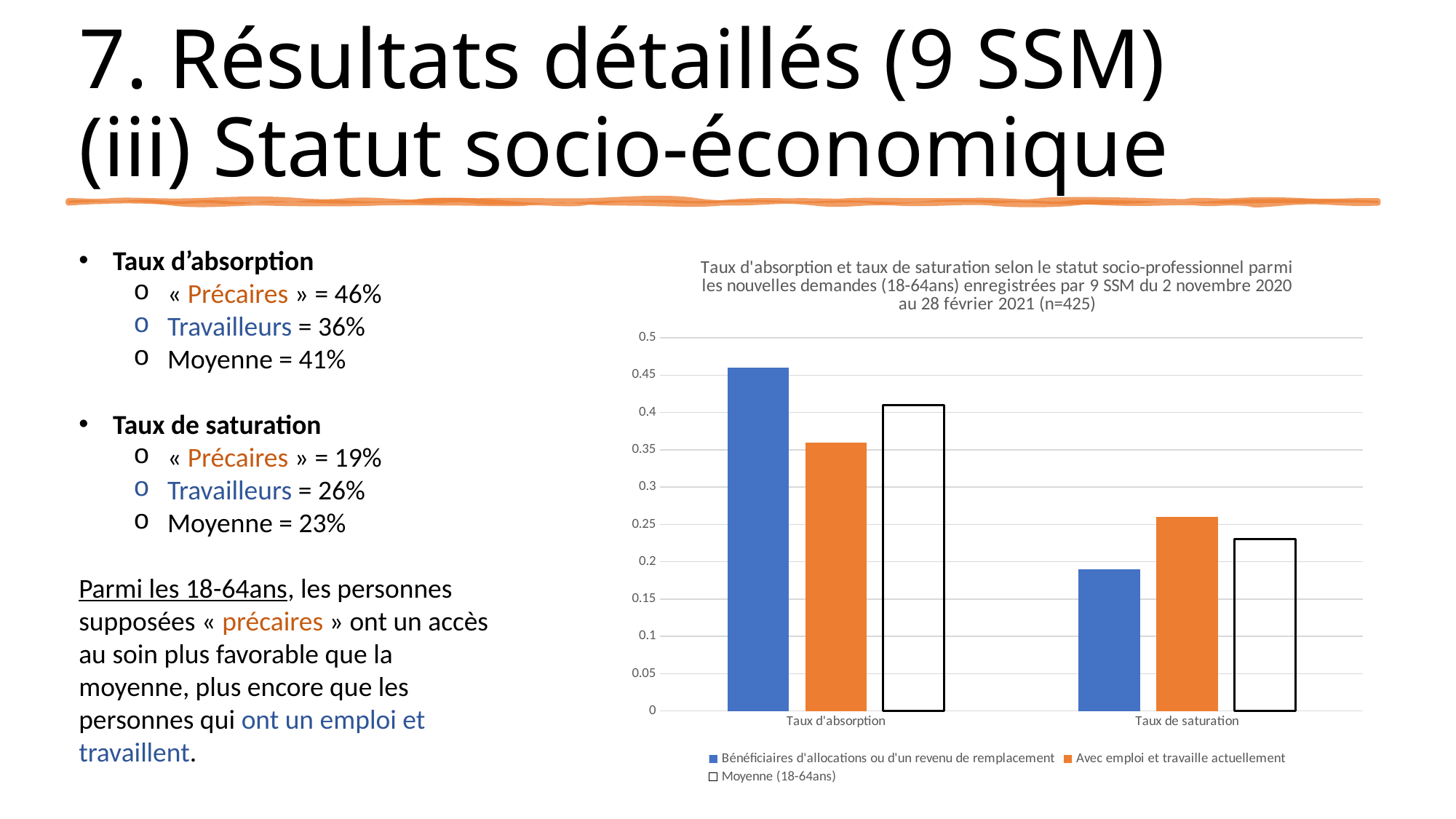
Do the values for each series rise or fall from Taux d'absorption to Taux de saturation? fall Is the value for Bénéficiaires d'allocations ou d'un revenu de remplacement in Taux d'absorption greater or less than 0.4? greater For Taux d'absorption, which is larger: Bénéficiaires d'allocations ou d'un revenu de remplacement or Avec emploi et travaille actuellement? Bénéficiaires d'allocations ou d'un revenu de remplacement Is the value for Moyenne (18-64ans) in Taux de saturation greater or less than 0.25? less How is the Moyenne (18-64ans) series drawn in the chart? white bars with a black outline What kind of chart is shown on the slide? bar chart Is the value for Avec emploi et travaille actuellement in Taux d'absorption greater or less than 0.4? less For Taux de saturation, which is larger: Bénéficiaires d'allocations ou d'un revenu de remplacement or Avec emploi et travaille actuellement? Avec emploi et travaille actuellement How many series does the chart legend list? 3 Which series has the highest bar in the chart? Bénéficiaires d'allocations ou d'un revenu de remplacement (Taux d'absorption) Which bar is the lowest in the chart? Bénéficiaires d'allocations ou d'un revenu de remplacement (Taux de saturation) How many categories are shown on the x axis of the chart? 2